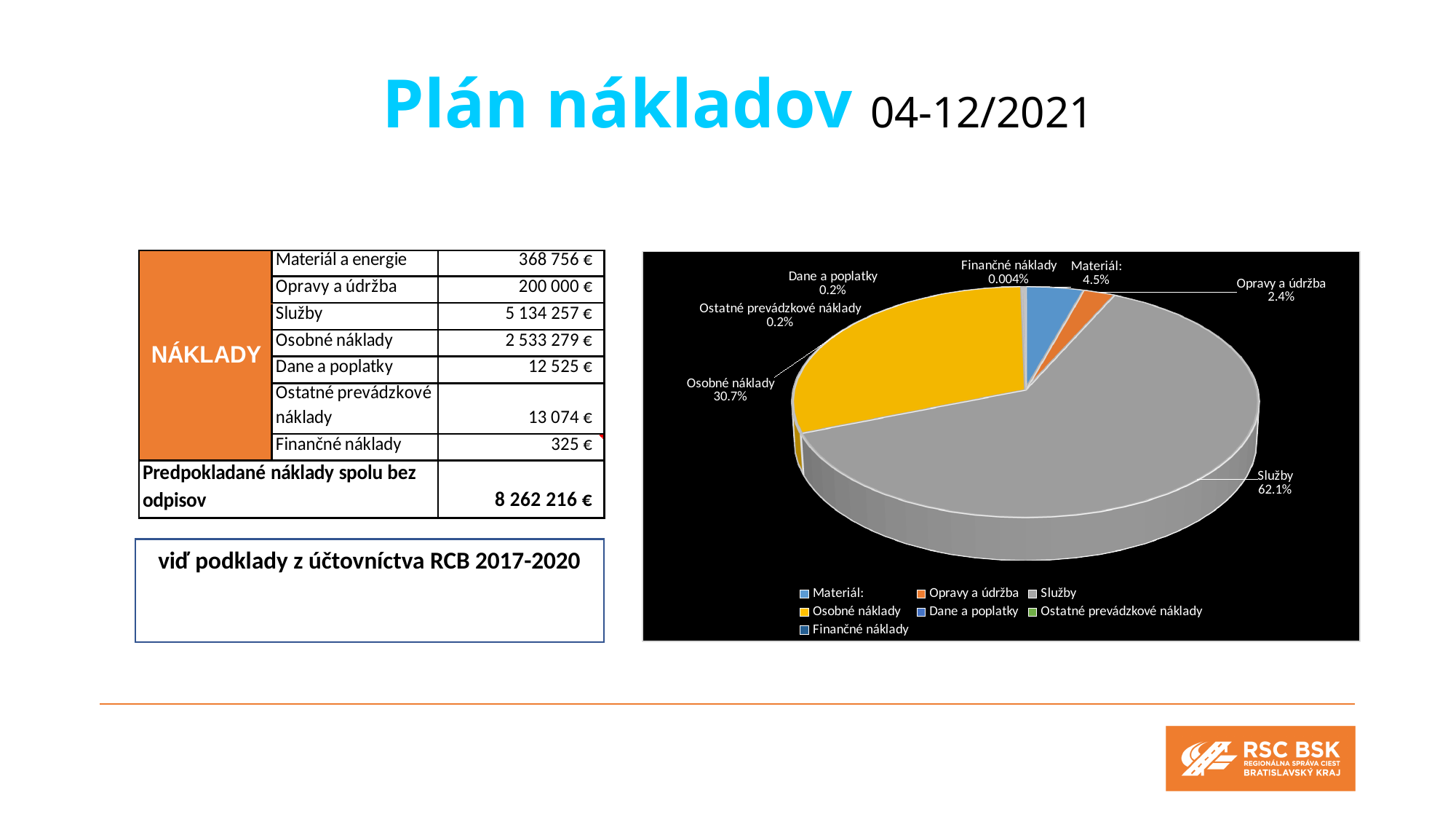
What percentage is shown for Finančné náklady in the pie chart? 0.004% Which category has the smallest slice of the pie? Finančné náklady What kind of chart is shown on the slide? pie chart What percentage is shown for Materiál in the pie chart? 4.5% Which slice is larger, Materiál or Opravy a údržba? Materiál Which category has the largest slice of the pie? Služby How many entries does the legend of the pie chart list? 7 What percentage is shown for Opravy a údržba in the pie chart? 2.4% What share of the pie does Osobné náklady represent? 30.7% What share of the pie does Služby represent? 62.1% What colour is the Osobné náklady slice in the pie chart? yellow By how many percentage points does the Služby share exceed the Osobné náklady share? 31.4